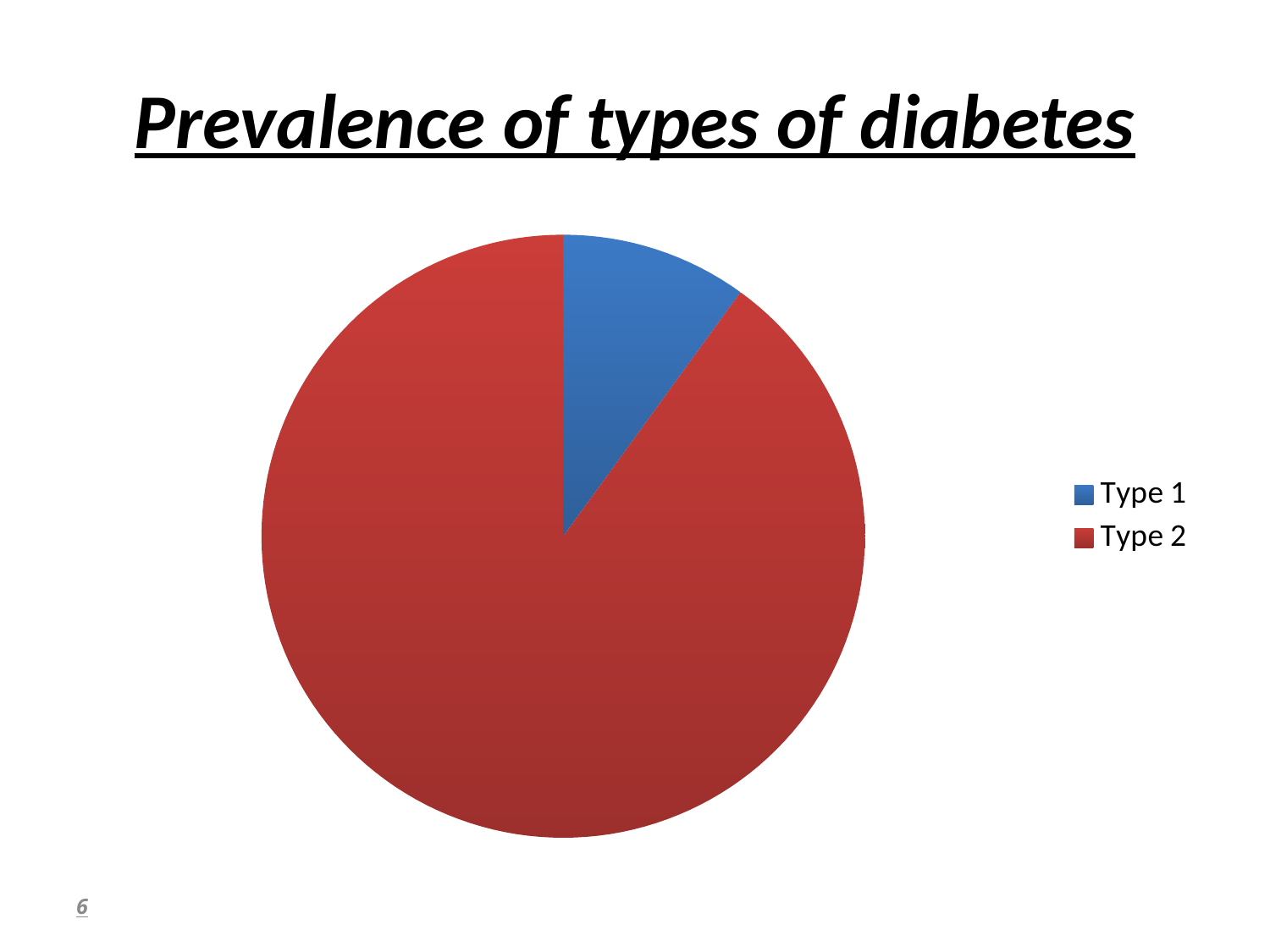
What kind of chart is shown on the slide? pie chart How many entries does the legend list? 2 Which slice is larger, Type 1 or Type 2? Type 2 Which type of diabetes has the largest slice of the pie? Type 2 How many slices does the pie chart have? 2 What is the title of the chart on the slide? Prevalence of types of diabetes What colour is the Type 2 slice in the pie chart? red Which type of diabetes has the smallest slice of the pie? Type 1